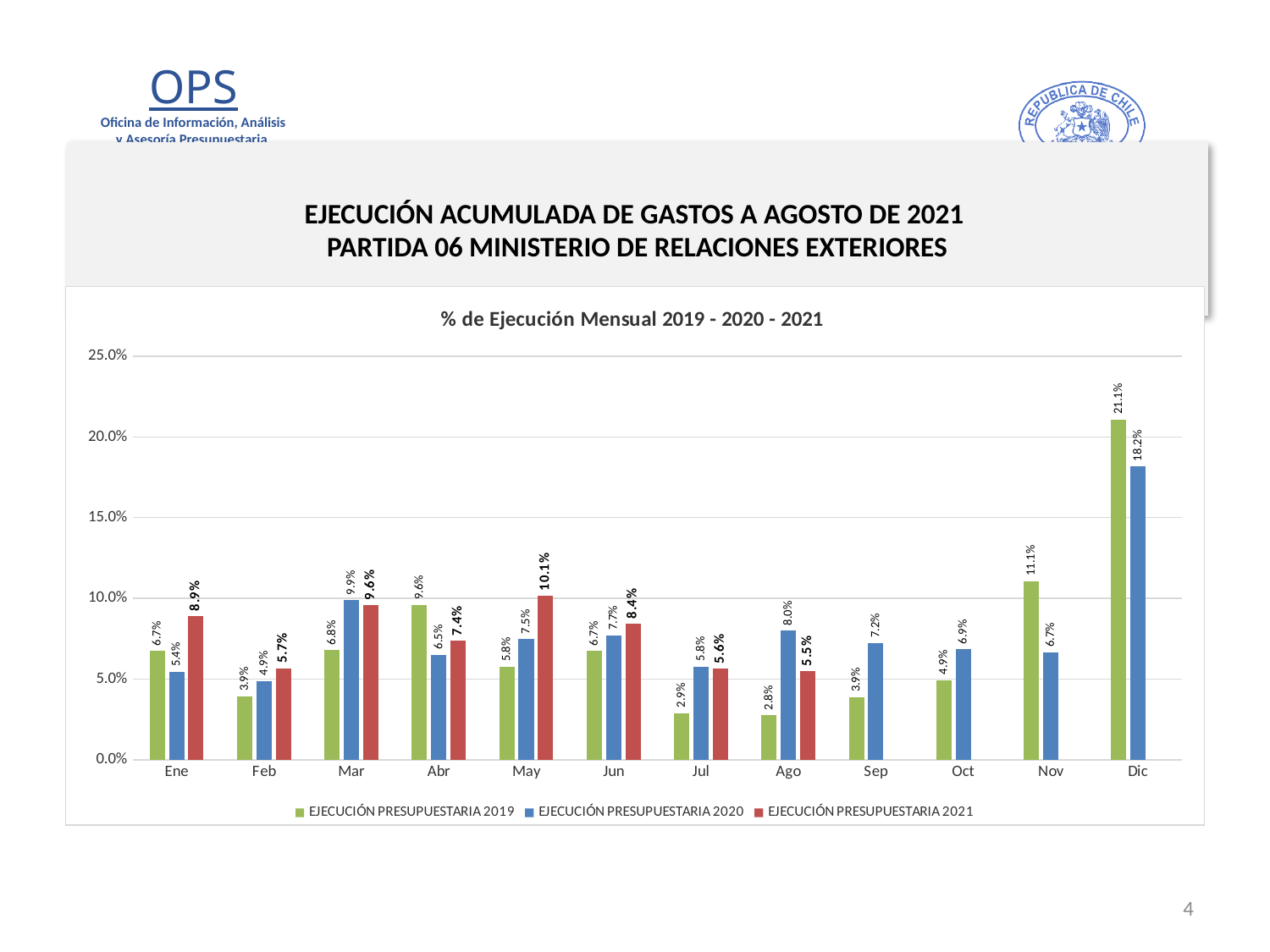
What is the title of the chart? % de Ejecución Mensual 2019 - 2020 - 2021 How many series does the legend list? 3 What is the value for EJECUCIÓN PRESUPUESTARIA 2021 in May? 10.1% How many months are shown on the x axis? 12 What is the value for EJECUCIÓN PRESUPUESTARIA 2019 in Dic? 21.1% What is the difference between the 2019 and 2020 values in Dic? 2.9% What kind of chart is shown? Bar chart What is the value for EJECUCIÓN PRESUPUESTARIA 2020 in Ago? 8.0% Which month has the lowest value for EJECUCIÓN PRESUPUESTARIA 2019? Ago Which is larger in Mar: the 2020 value or the 2021 value? 2020 (9.9%) Which month has the highest value for EJECUCIÓN PRESUPUESTARIA 2021? May Is the value for EJECUCIÓN PRESUPUESTARIA 2019 in Nov greater or less than 10.0%? greater